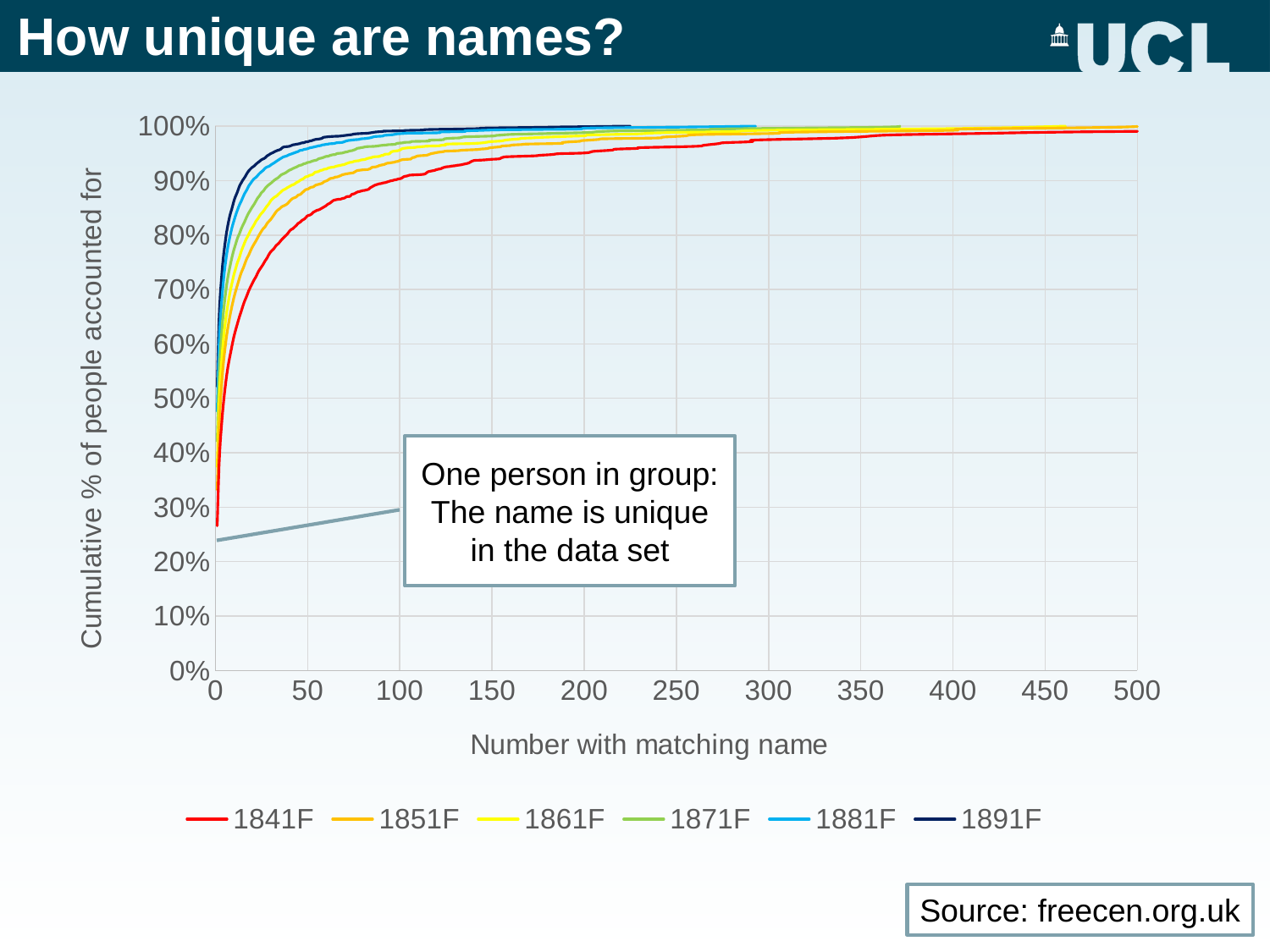
Is the value for 1891F at 50 on the x axis greater or less than 90%? greater Which series has the highest cumulative percentage across the range of the x axis? 1891F What kind of chart is shown on the slide? line chart Do the values of the 1841F series rise or fall as the number with matching name increases? rise At 100 on the x axis, which series is higher: 1851F or 1881F? 1881F Is the value for 1841F at 50 on the x axis greater or less than 70%? greater What is the label of the x axis? Number with matching name Which series has the lowest cumulative percentage across the range of the x axis? 1841F Is the starting value of the 1841F series at 0 on the x axis greater or less than 30%? less How many series does the legend list? 6 At 50 on the x axis, which series is higher: 1841F or 1891F? 1891F What colour is the line for the 1841F series? red